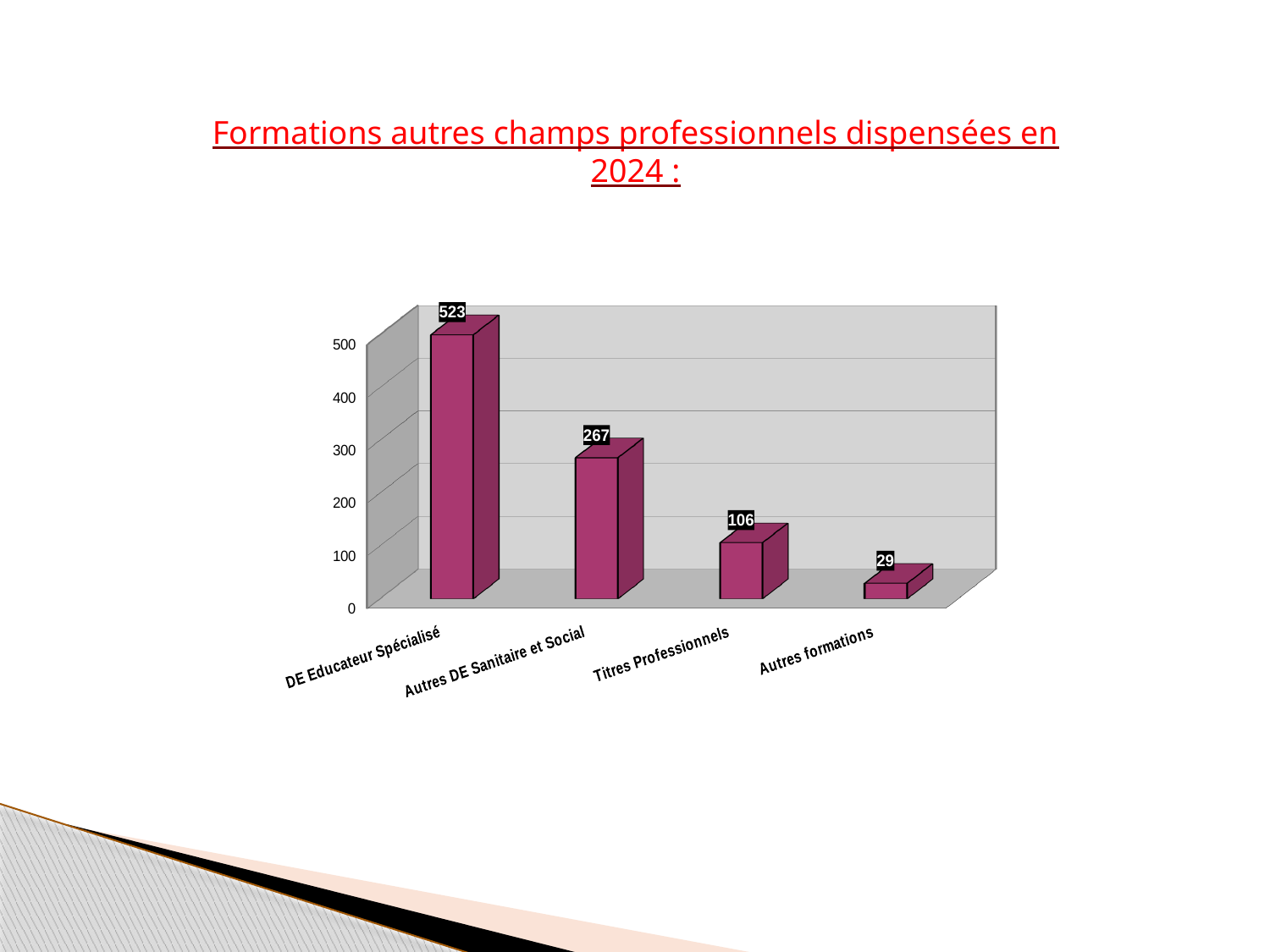
What is the value for Autres DE Sanitaire et Social? 267 Which category has the lowest value? Autres formations Do the values rise or fall from left to right along the x axis? fall How many categories are shown on the chart? 4 What kind of chart is shown on the slide? bar chart What is the value for Autres formations? 29 What is the value for Titres Professionnels? 106 What is the difference between the values for DE Educateur Spécialisé and Autres DE Sanitaire et Social? 256 What is the difference between the values for Titres Professionnels and Autres formations? 77 Which is larger, the value for Autres DE Sanitaire et Social or the value for Titres Professionnels? Autres DE Sanitaire et Social Which category has the highest value? DE Educateur Spécialisé What is the value for DE Educateur Spécialisé? 523